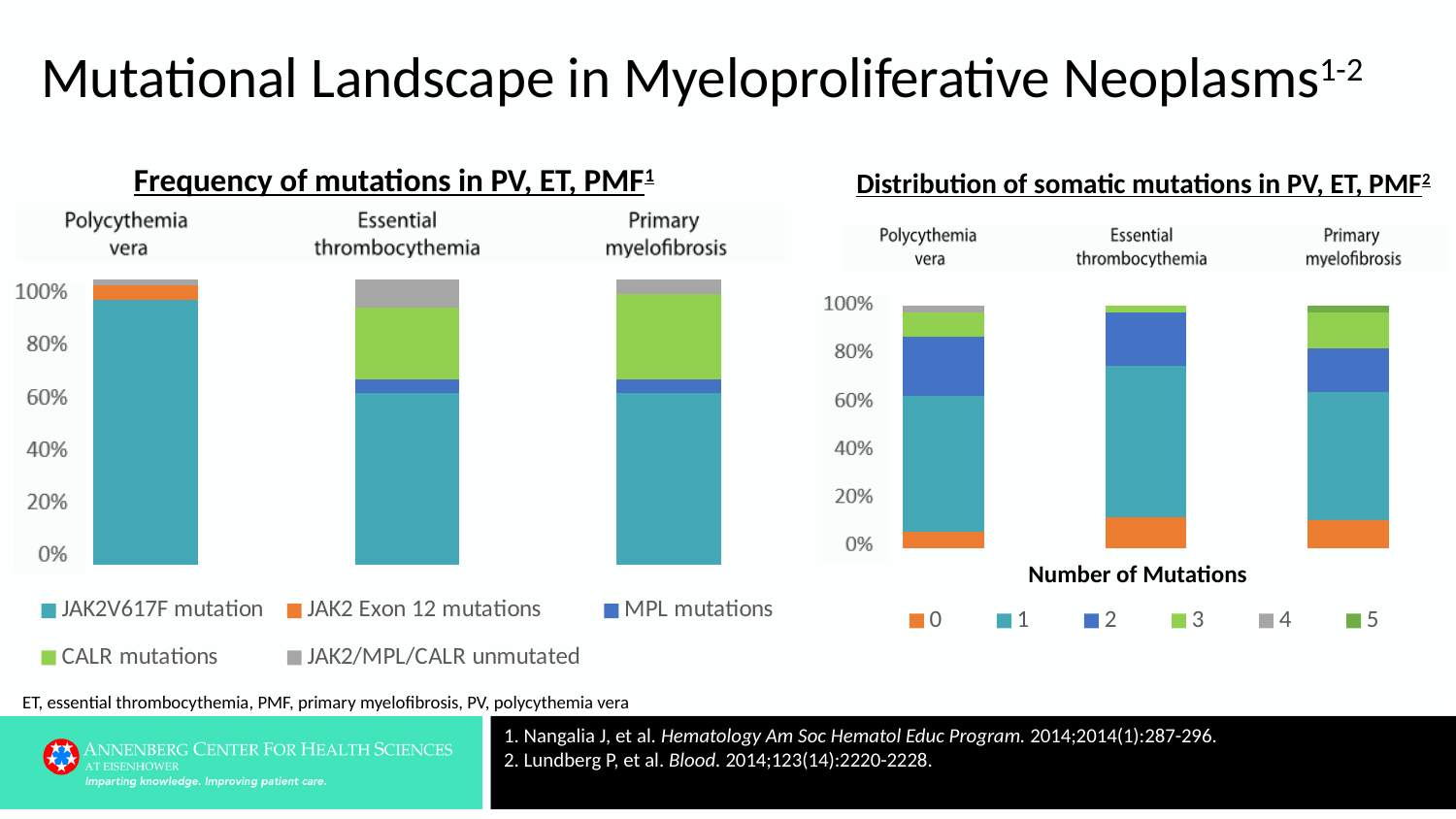
In the 'Distribution of somatic mutations in PV, ET, PMF' chart, is the share of patients with 1 mutation in Essential thrombocythemia greater or less than 40%? greater How many series does the legend of the 'Frequency of mutations in PV, ET, PMF' chart list? 5 What kind of chart is the 'Frequency of mutations in PV, ET, PMF' chart? Stacked bar chart In the 'Frequency of mutations in PV, ET, PMF' chart, which disease has the largest JAK2V617F mutation share? Polycythemia vera How many series does the legend of the 'Distribution of somatic mutations in PV, ET, PMF' chart list? 6 In the 'Frequency of mutations in PV, ET, PMF' chart, is the JAK2V617F mutation share for Polycythemia vera greater or less than 80%? greater What is the x-axis label of the 'Distribution of somatic mutations in PV, ET, PMF' chart? Number of Mutations In the 'Distribution of somatic mutations in PV, ET, PMF' chart, is the share of Polycythemia vera patients with 0 mutations greater or less than 20%? less In the 'Frequency of mutations in PV, ET, PMF' chart, which legend entry is shown in green? CALR mutations In the 'Frequency of mutations in PV, ET, PMF' chart, is the JAK2V617F mutation segment larger for Polycythemia vera or for Essential thrombocythemia? Polycythemia vera How many disease categories are shown on the x axis of the 'Frequency of mutations in PV, ET, PMF' chart? 3